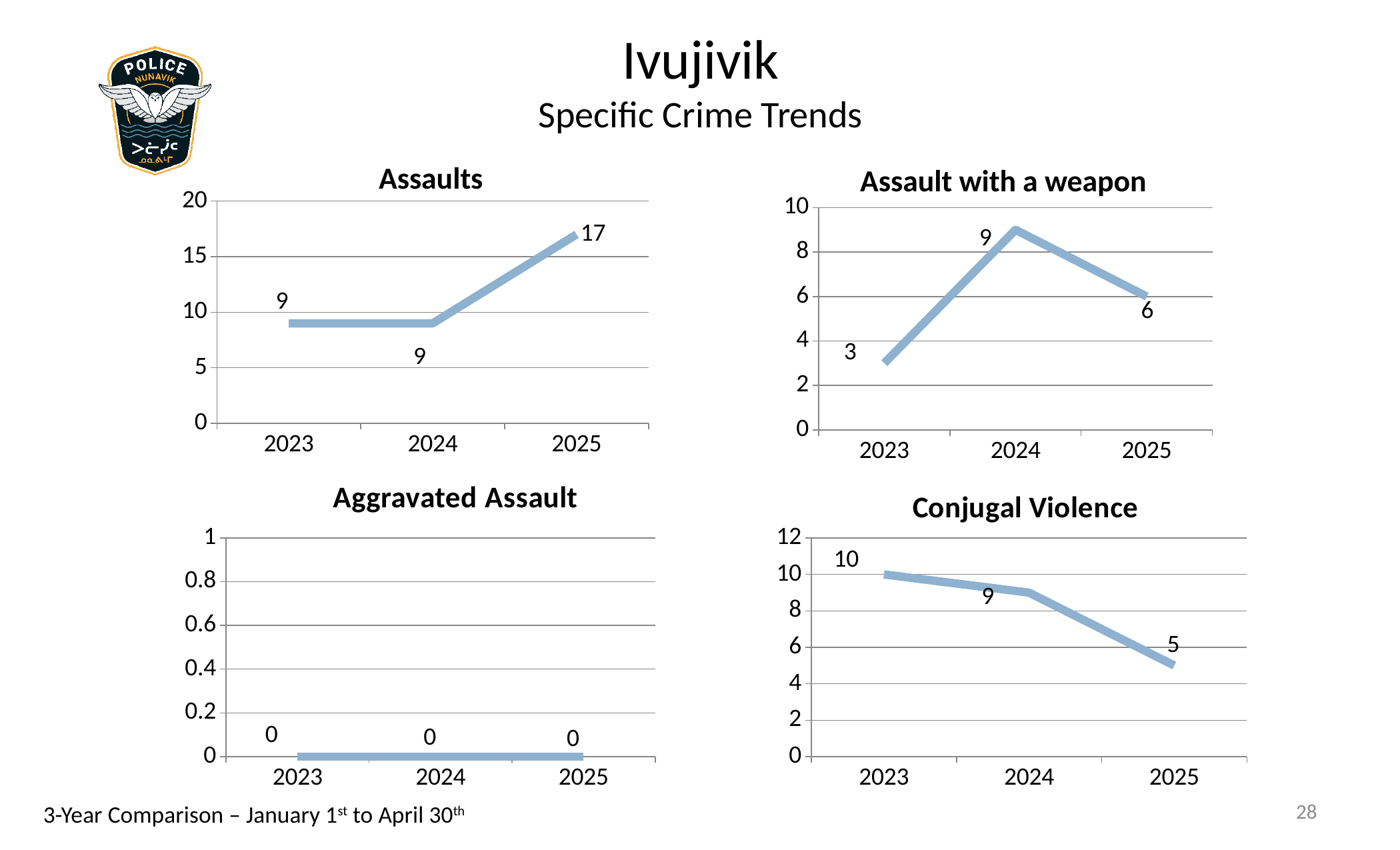
What is the title of the chart in the bottom-left of the slide? Aggravated Assault In the Assault with a weapon chart, which year has the larger value, 2023 or 2025? 2025 How many years are plotted in the Aggravated Assault chart? 3 What kind of chart is the Conjugal Violence chart? Line chart In the Conjugal Violence chart, what is the difference between the 2023 value and the 2025 value? 5 In the Conjugal Violence chart, do the values rise or fall from 2023 to 2025? Fall In the Conjugal Violence chart, which year has the lowest value? 2025 In the Assault with a weapon chart, what is the value for 2023? 3 In the Assault with a weapon chart, which year has the highest value? 2024 In the Assaults chart, what is the value for 2025? 17 In the Conjugal Violence chart, what is the value for 2024? 9 In the Assaults chart, what is the difference between the 2025 value and the 2024 value? 8